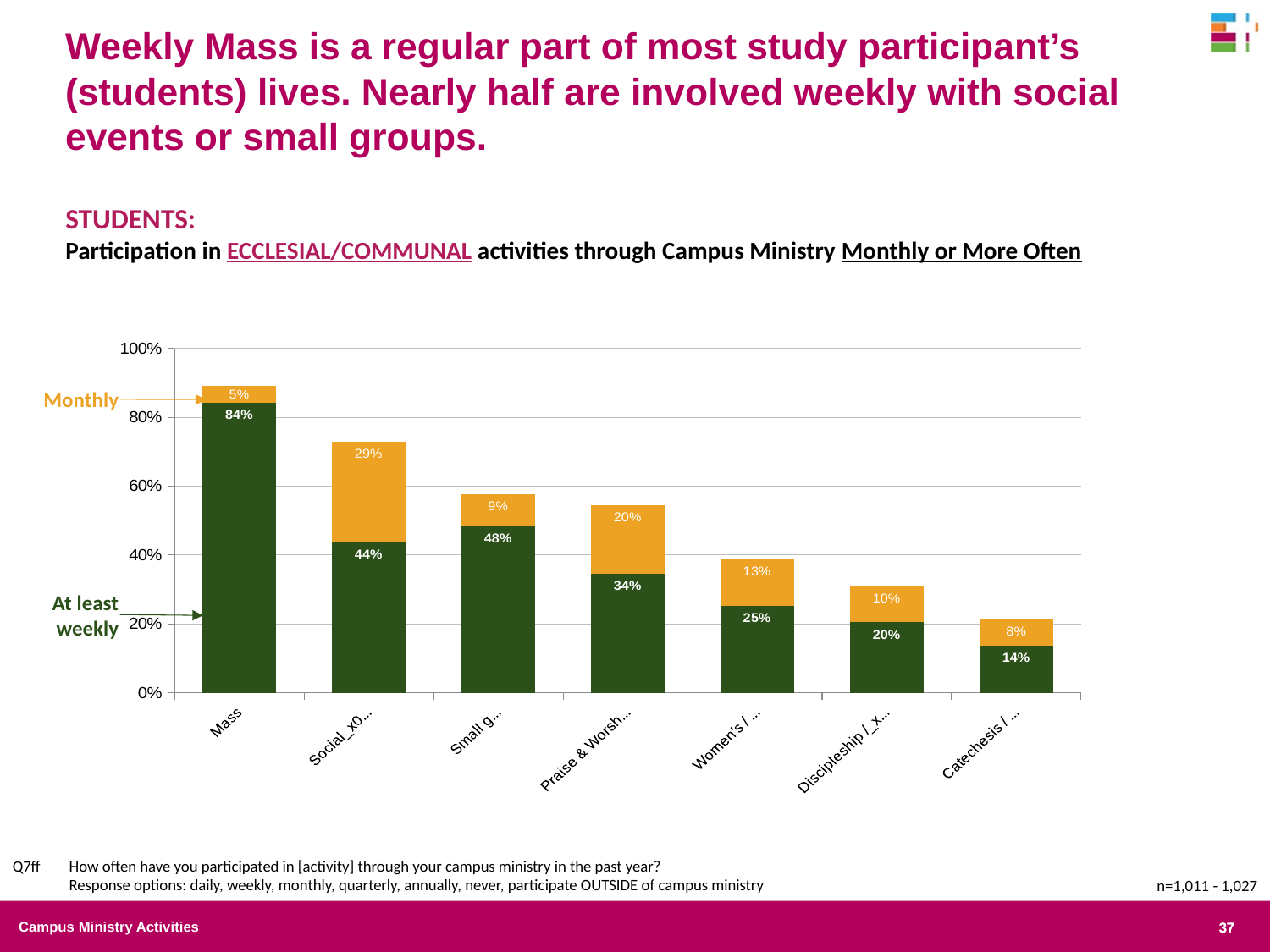
Which colour represents the 'Monthly' segment of each bar? Orange Do the total bar heights rise or fall from left to right across the chart? Fall How many activity categories are plotted on the chart? 7 What is the 'at least weekly' value for the rightmost bar on the chart? 14% What is the Monthly value for Mass? 5% How many series are stacked in each bar? 2 What kind of chart is shown on the slide? Stacked bar chart Is the 'at least weekly' value for Mass greater or less than 80%? greater For Mass, which is larger: the 'at least weekly' value or the 'Monthly' value? At least weekly Which activity has the highest 'at least weekly' participation? Mass What percentage of students participate in Mass at least weekly? 84% What is the combined total of the Mass bar (at least weekly plus monthly)? 89%